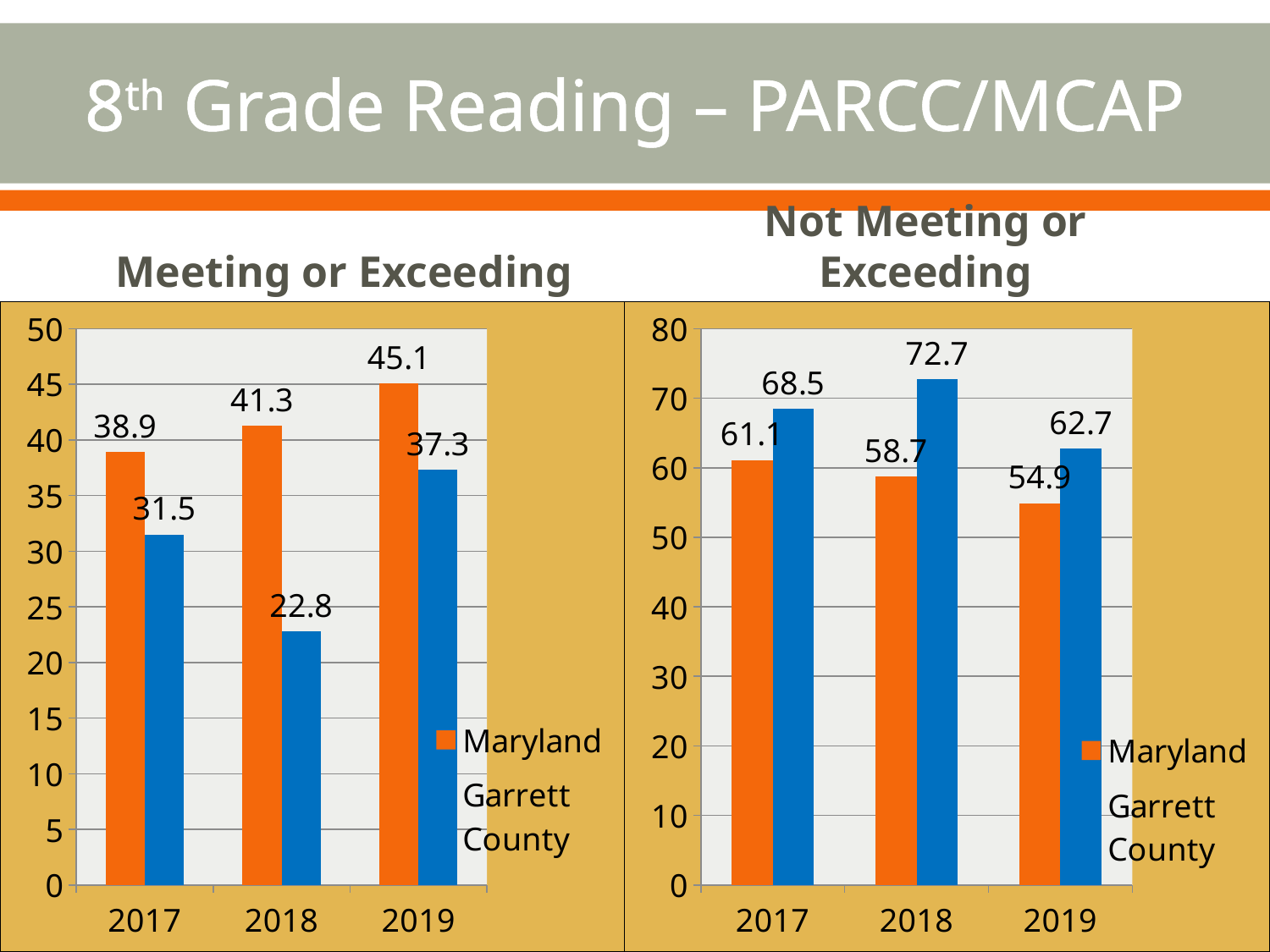
In the 'Meeting or Exceeding' chart, what is the value for Garrett County in 2018? 22.8 In the 'Meeting or Exceeding' chart, which year has the lowest Garrett County value? 2018 In the 'Not Meeting or Exceeding' chart, what is the value for Garrett County in 2018? 72.7 What kind of chart is the 'Not Meeting or Exceeding' chart? Bar chart In the 'Not Meeting or Exceeding' chart, what is the value for Maryland in 2019? 54.9 In the 'Not Meeting or Exceeding' chart, what is the difference between Garrett County and Maryland in 2017? 7.4 In the 'Meeting or Exceeding' chart, what is the value for Maryland in 2019? 45.1 In the 'Meeting or Exceeding' chart, which year has the highest Maryland value? 2019 In the 'Meeting or Exceeding' chart, what is the difference between Maryland and Garrett County in 2018? 18.5 In the 'Meeting or Exceeding' chart, do the Maryland values rise or fall from 2017 to 2019? Rise In the 'Not Meeting or Exceeding' chart, which is larger in 2019, Maryland or Garrett County? Garrett County How many series does the legend of the 'Meeting or Exceeding' chart list? 2